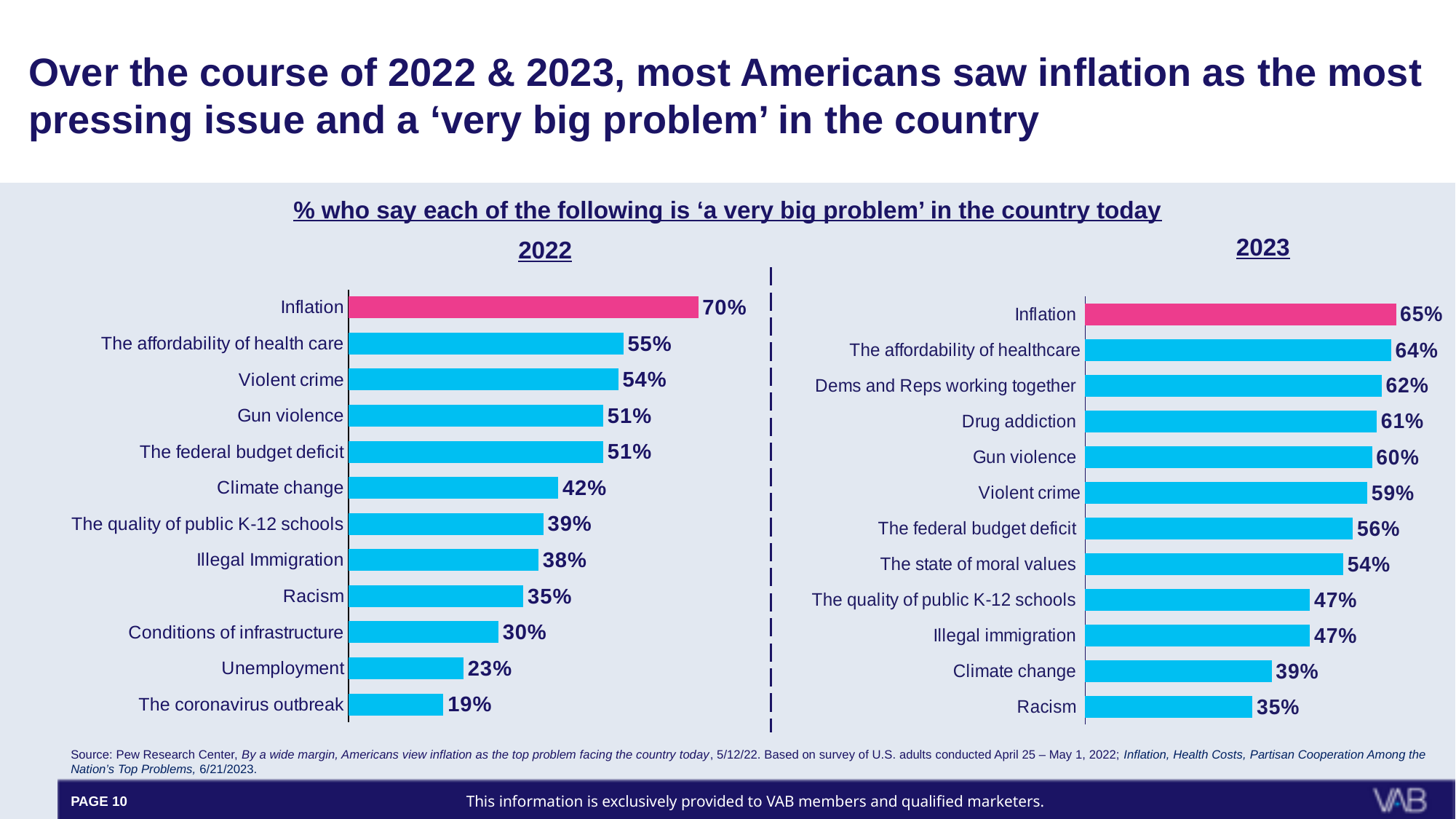
How many categories are shown in the 2022 chart? 12 In the 2022 chart, which category has the lowest value? The coronavirus outbreak In the 2023 chart, what is the value for Dems and Reps working together? 62% In the 2023 chart, which category has the lowest value? Racism In the 2023 chart, what percentage say drug addiction is a very big problem? 61% In the 2023 chart, which category has the highest value? Inflation In the 2022 chart, which is larger: the value for climate change or the value for racism? Climate change What is the difference between the inflation value in the 2022 chart and the inflation value in the 2023 chart? 5% In the 2022 chart, what percentage say inflation is a very big problem? 70% In the 2022 chart, what is the difference between the values for inflation and the affordability of health care? 15% What type of chart is used for the 2023 data? Bar chart In the 2023 chart, which bar is coloured differently from the others? Inflation